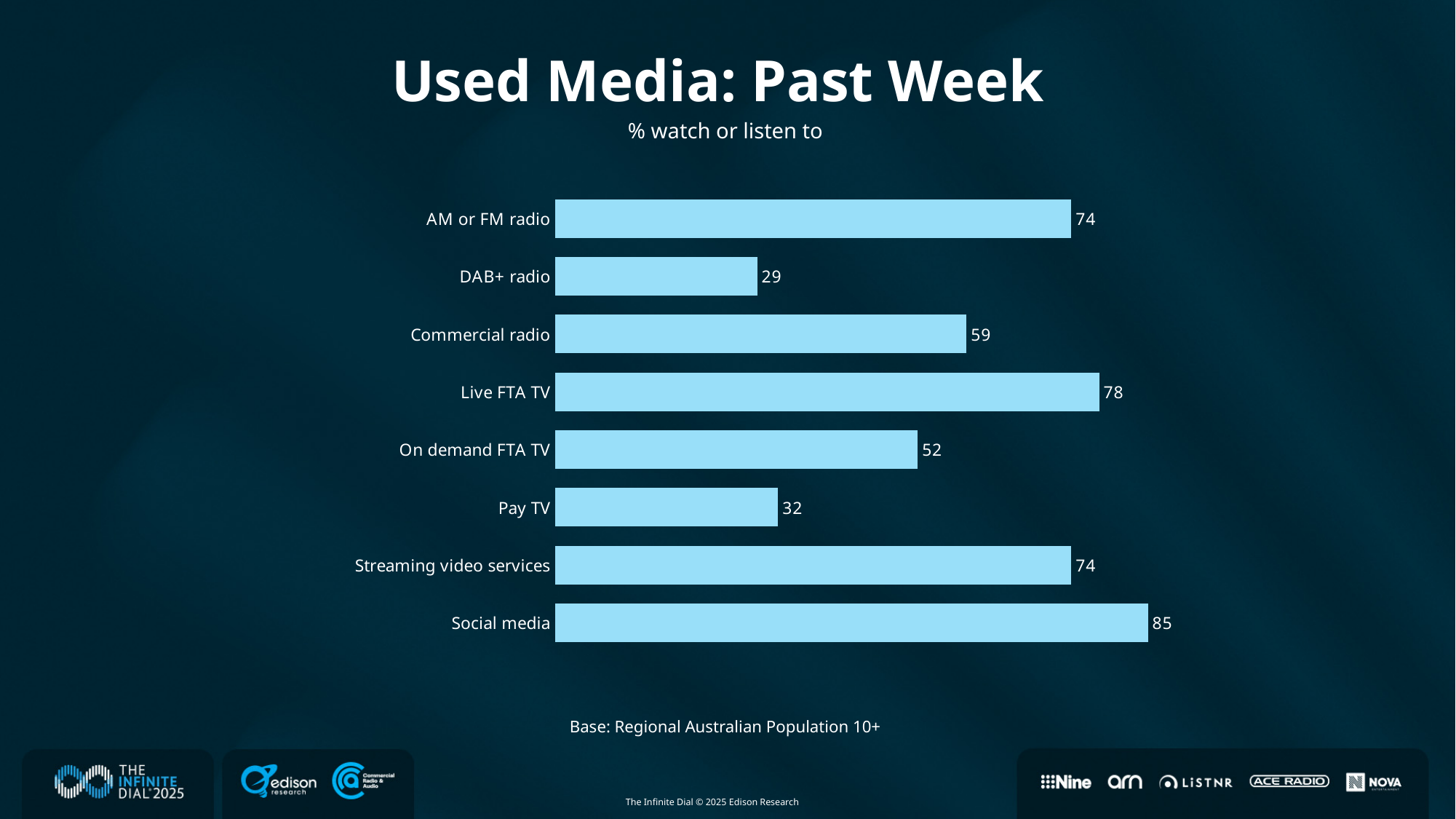
How many categories are shown in the chart? 8 Which is larger, the value for Commercial radio or the value for On demand FTA TV? Commercial radio What is the title of the chart? Used Media: Past Week Which category has the highest value? Social media What population is the chart based on, according to the note below it? Regional Australian Population 10+ Which category has the lowest value? DAB+ radio What is the difference between the values for Social media and Pay TV? 53 What is the difference between the values for Live FTA TV and Commercial radio? 19 What is the value for AM or FM radio? 74 What is the value for On demand FTA TV? 52 What kind of chart is shown on the slide? Bar chart What is the value for DAB+ radio? 29